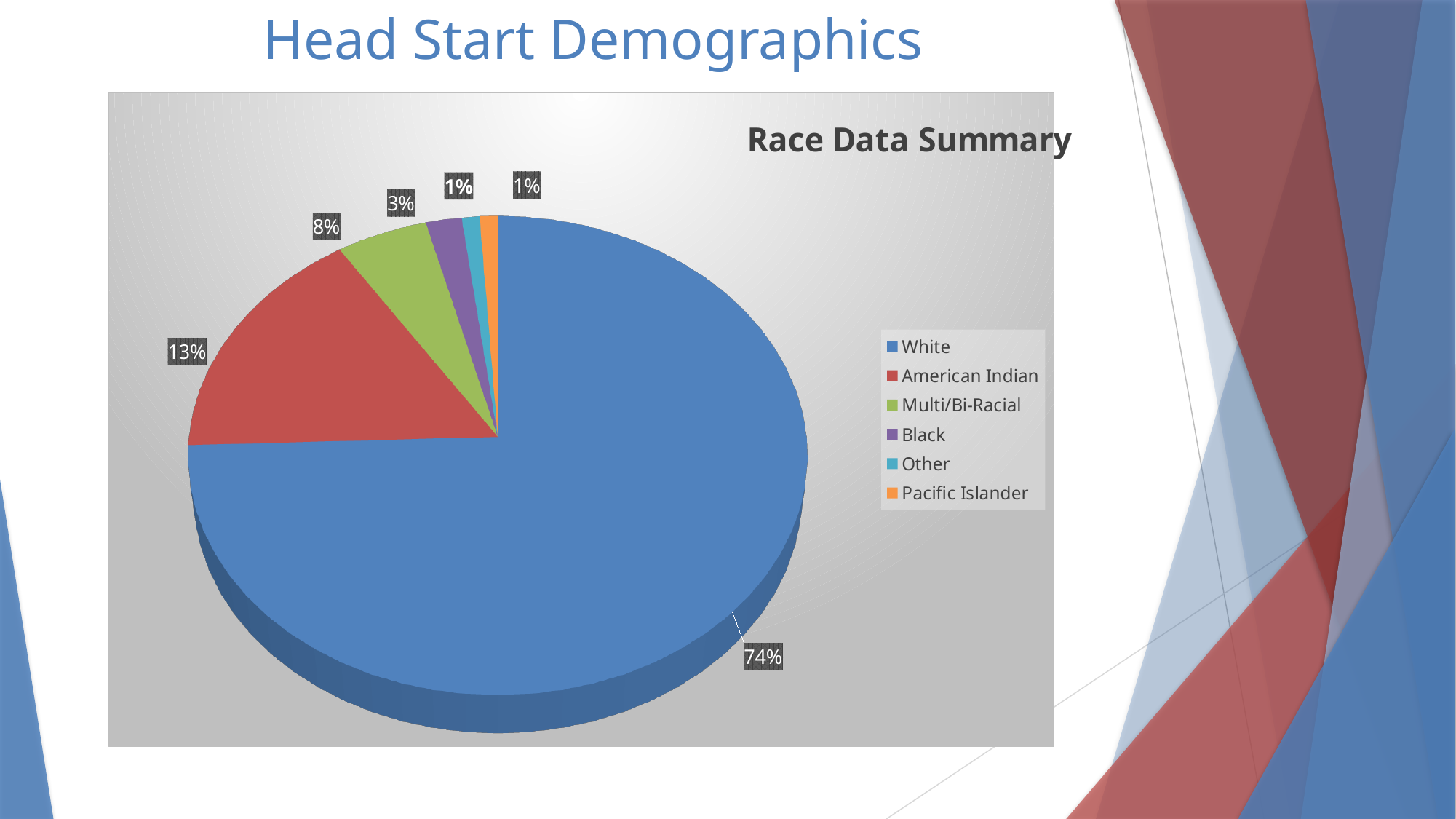
What percentage is shown for American Indian? 13% How many categories does the legend list? 6 What is the title of the chart? Race Data Summary Which is larger, the share for Multi/Bi-Racial or the share for Black? Multi/Bi-Racial What is the difference in percentage points between White and American Indian? 61 What kind of chart is shown on the slide? Pie chart What percentage is shown for Black? 3% What percentage is shown for Pacific Islander? 1% What percentage is shown for Multi/Bi-Racial? 8% Which category has the largest slice of the pie? White What share of the pie does White represent? 74% What is the difference in percentage points between American Indian and Multi/Bi-Racial? 5